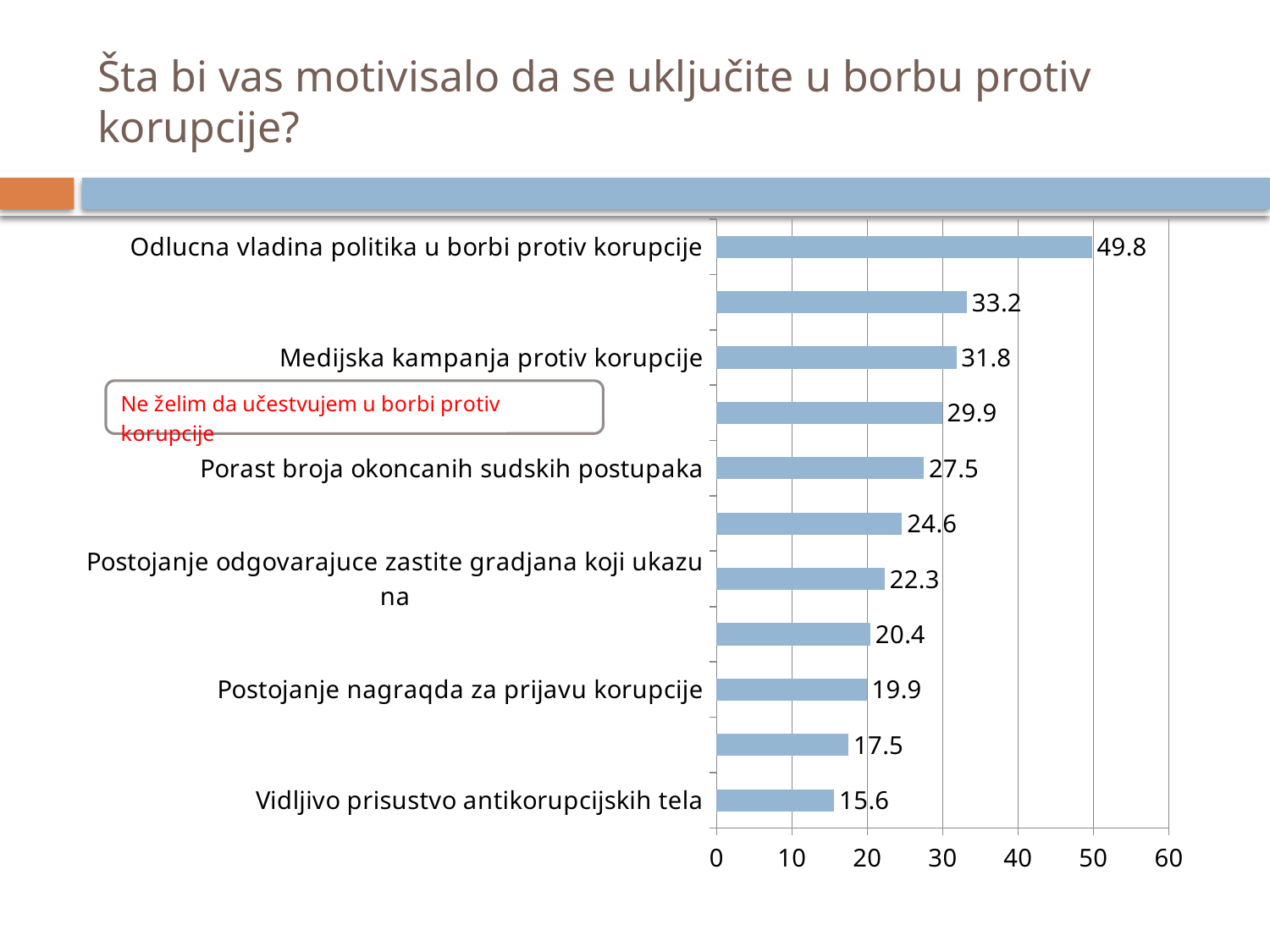
What is the difference between the values for "Odlucna vladina politika u borbi protiv korupcije" and "Medijska kampanja protiv korupcije"? 18 Which is larger: the value for "Porast broja okoncanih sudskih postupaka" or for "Postojanje nagraqda za prijavu korupcije"? Porast broja okoncanih sudskih postupaka What is the value for "Vidljivo prisustvo antikorupcijskih tela"? 15.6 Which category has the lowest value? Vidljivo prisustvo antikorupcijskih tela How many bars are plotted in the chart? 11 What is the value for "Postojanje nagraqda za prijavu korupcije"? 19.9 What kind of chart is shown on the slide? bar chart What is the value for "Medijska kampanja protiv korupcije"? 31.8 Which category has the highest value? Odlucna vladina politika u borbi protiv korupcije Is the value for "Medijska kampanja protiv korupcije" greater or less than 30? greater What is the value for "Porast broja okoncanih sudskih postupaka"? 27.5 What is the value for "Odlucna vladina politika u borbi protiv korupcije"? 49.8